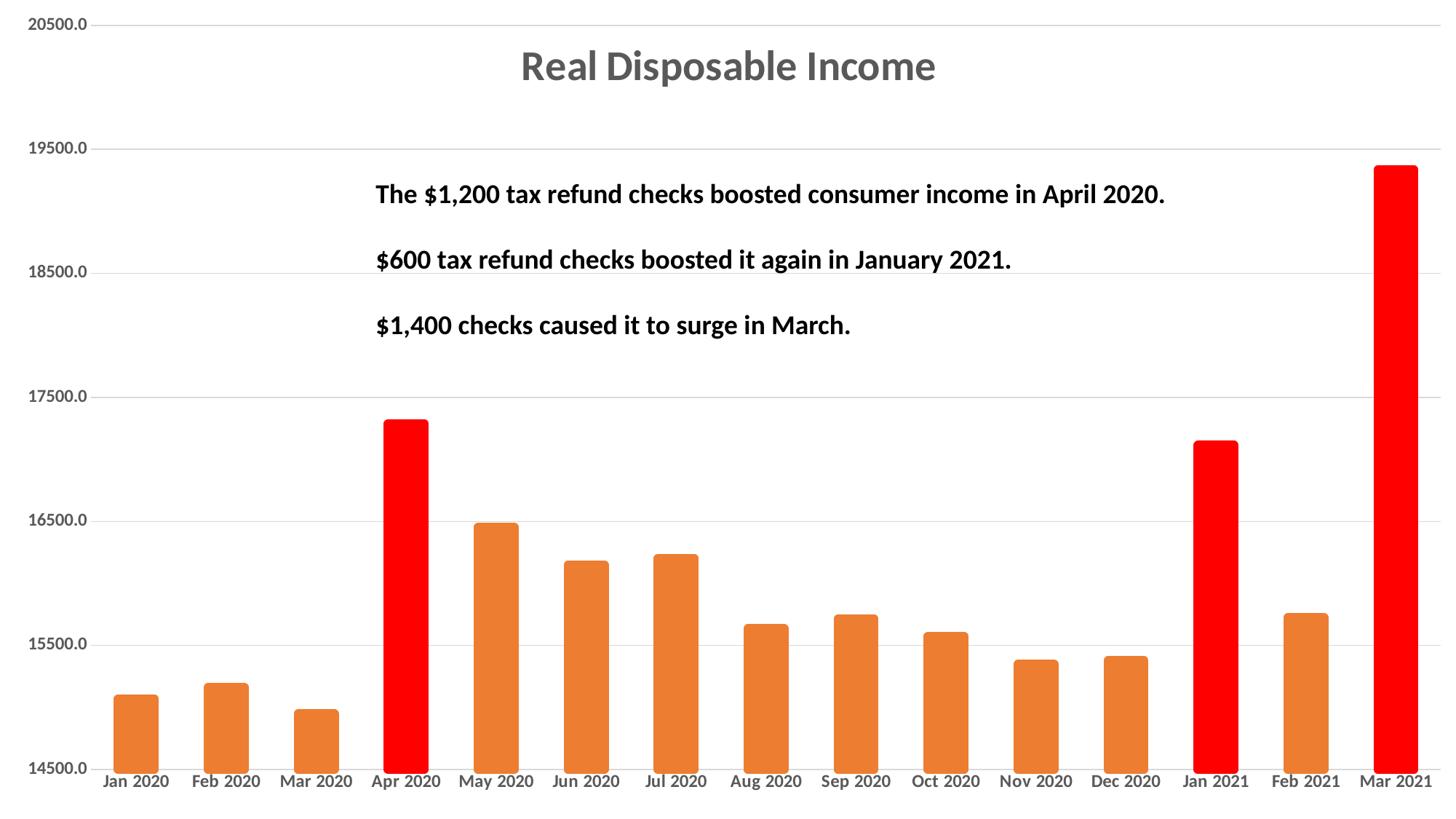
Which is higher, the value for May 2020 or the value for Feb 2021? May 2020 Is the value for Apr 2020 greater or less than 16500? greater What is the title of the chart? Real Disposable Income Is the value for Mar 2020 greater or less than 15500? less Which month has the highest real disposable income? Mar 2021 Is the value for Mar 2021 greater or less than 18500? greater Which month has the lowest real disposable income? Mar 2020 What kind of chart is shown on the slide? bar chart How many months are plotted on the x axis? 15 What colour are the bars for Apr 2020, Jan 2021 and Mar 2021? red